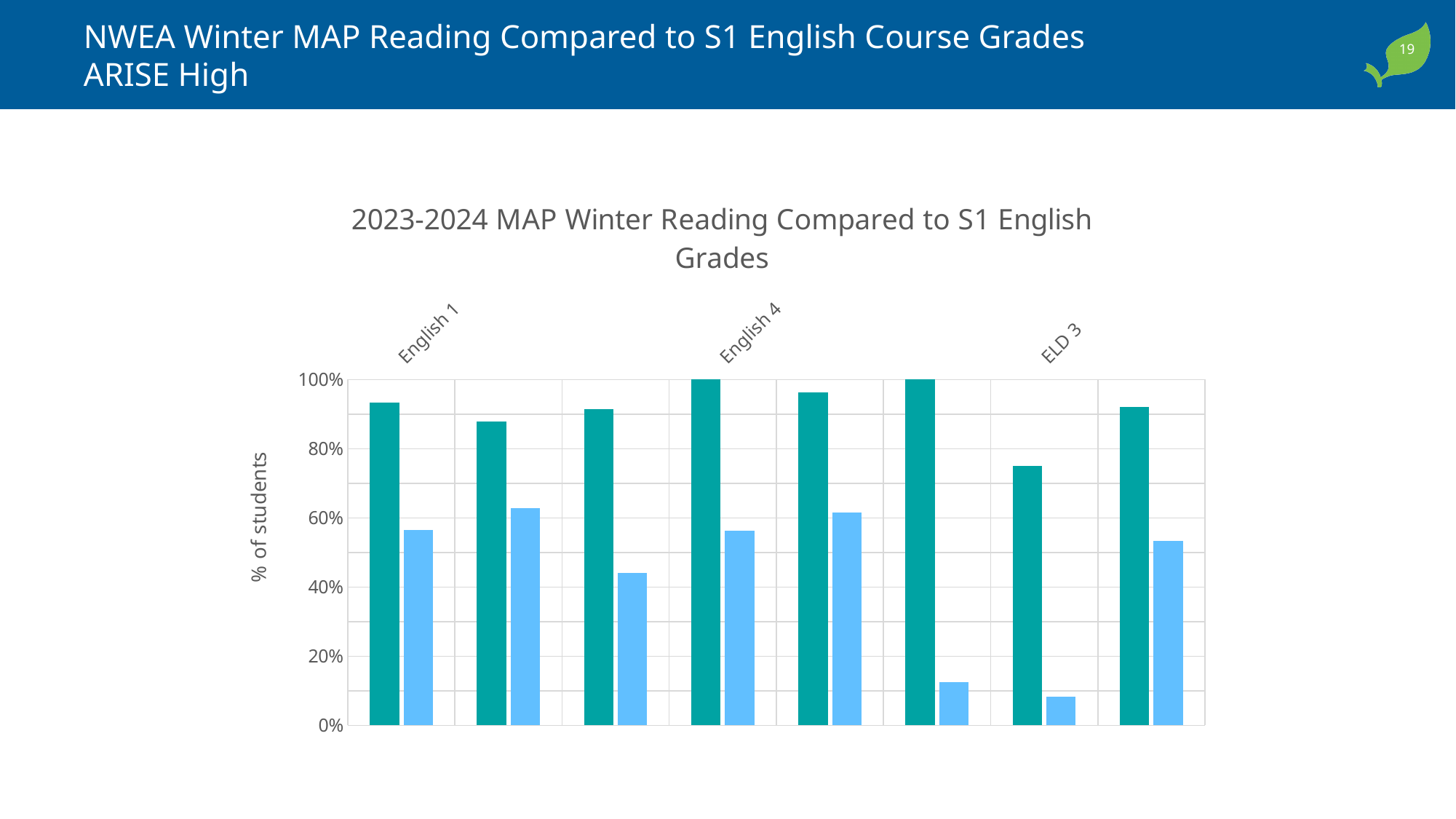
What type of chart is shown on the slide? bar chart How many groups of bars are plotted in the chart? 8 For ELD 3, which bar is taller, the teal bar or the light blue bar? the teal bar Is the value of the teal bar for English 1 greater or less than 80%? greater How many bar colours (series) are plotted in the chart? 2 What is the label on the vertical axis of the chart? % of students Is the value of the light blue bar for ELD 3 greater or less than 20%? less Is the value of the light blue bar for English 1 greater or less than 40%? greater What is the value of the teal bar for English 4? 100% What is the title of the chart? 2023-2024 MAP Winter Reading Compared to S1 English Grades